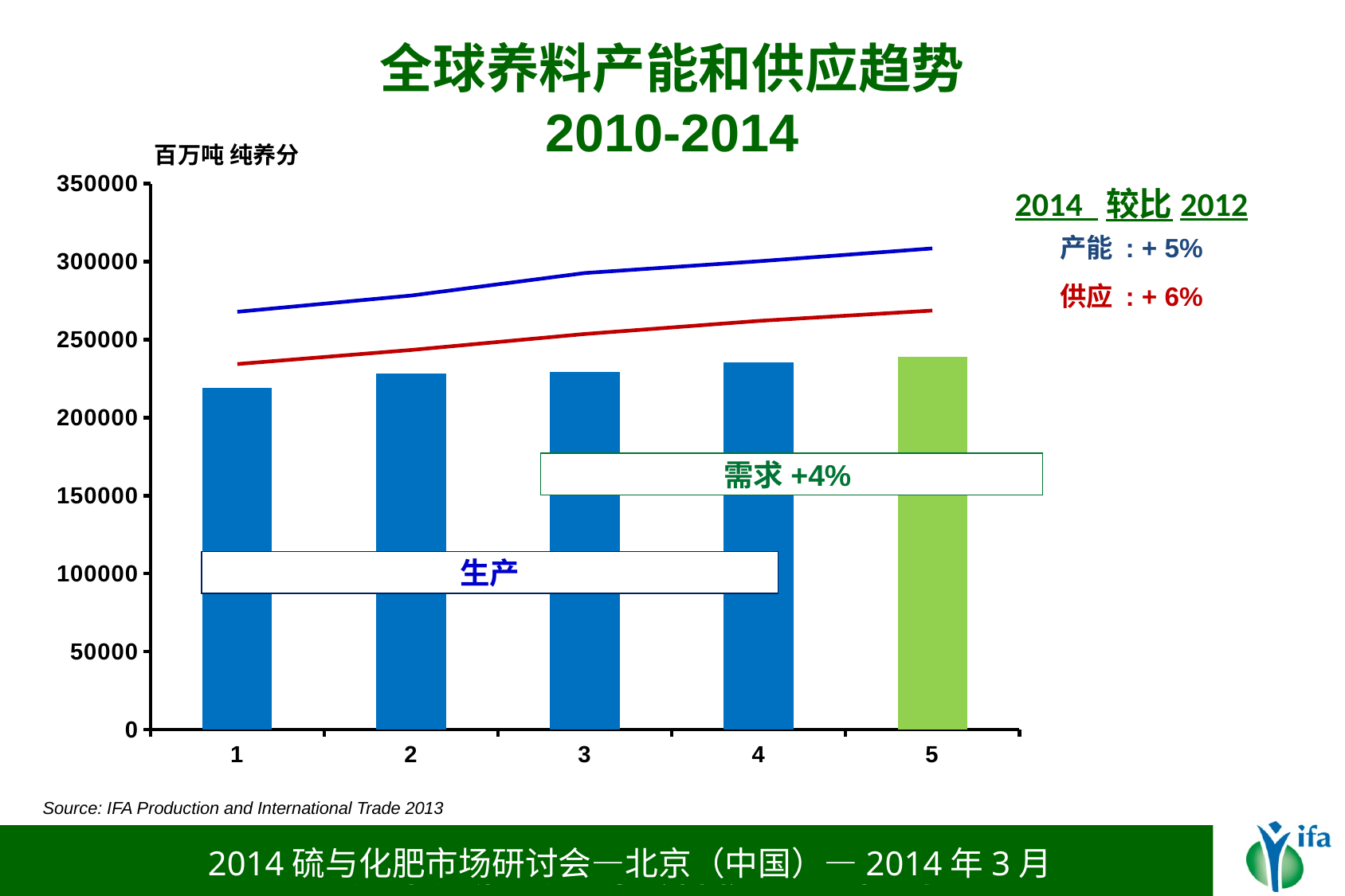
At category 3, which is higher, the blue line or the red line? the blue line What is the title of the chart on the slide? 全球养料产能和供应趋势 2010-2014 Which category has the lowest bar in the chart? 1 Which category has the tallest bar in the chart? 5 Is the blue line at category 5 greater or less than 300000? greater Is the bar for category 1 greater or less than 200000? greater Is the bar for category 5 greater or less than 250000? less Which bar is taller, category 1 or category 5? 5 Does the blue line rise or fall from category 1 to category 5? rise How many bars are plotted in the chart? 5 What unit label is shown above the y axis of the chart? 百万吨 纯养分